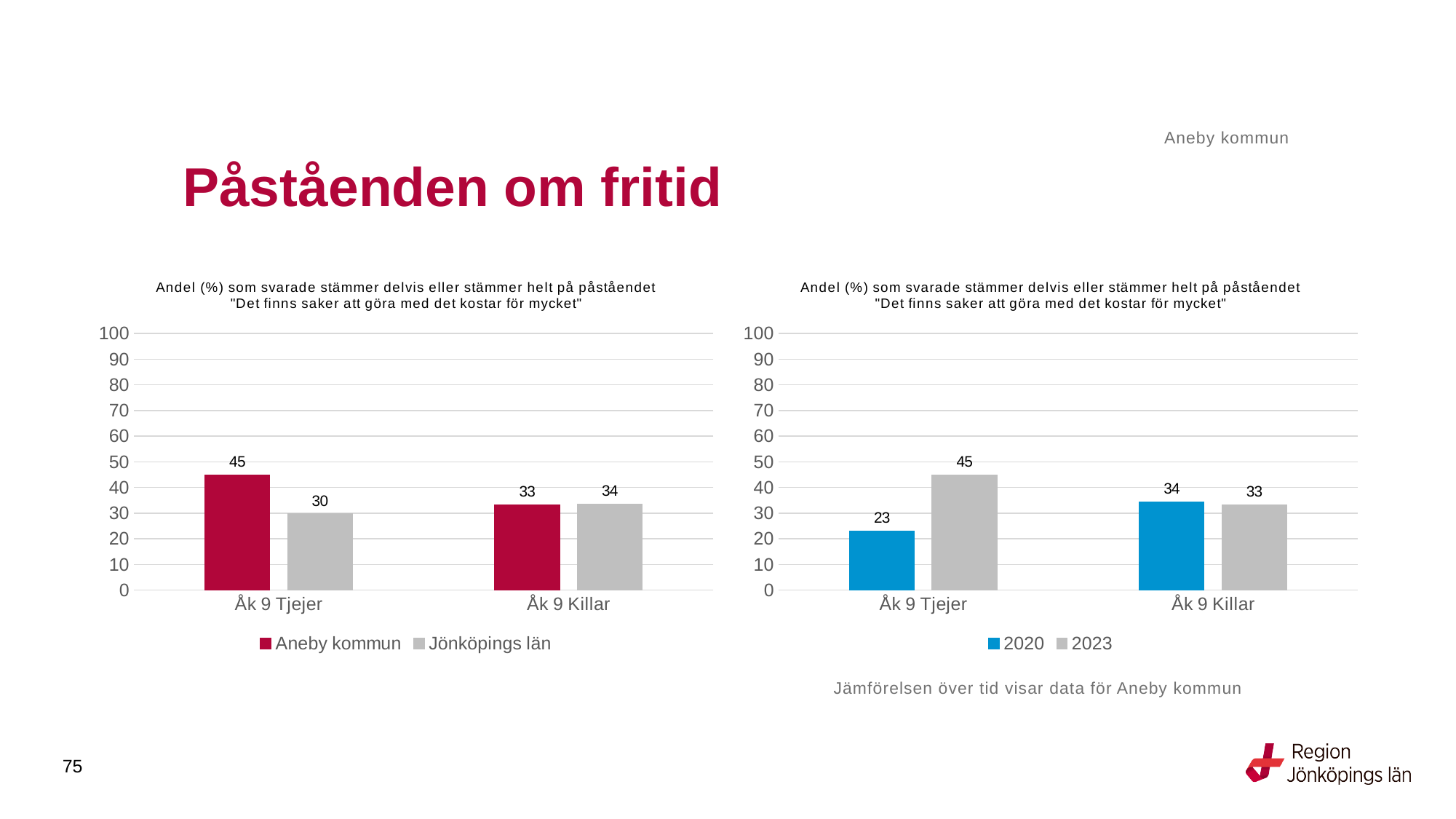
In the left chart, what is the value for Aneby kommun for Åk 9 Tjejer? 45 In the right chart, what is the difference between 2023 and 2020 for Åk 9 Tjejer? 22 In the right chart, which bar has the lowest value? 2020 for Åk 9 Tjejer In the left chart, which category has the highest value for Aneby kommun? Åk 9 Tjejer How many categories are shown on the x axis of the left chart? 2 In the left chart, what is the difference between Aneby kommun and Jönköpings län for Åk 9 Tjejer? 15 In the right chart, which is larger for Åk 9 Tjejer, 2020 or 2023? 2023 What type of chart is the left chart? Bar chart In the right chart, what is the value for 2023 for Åk 9 Killar? 33 In the left chart, what is the value for Jönköpings län for Åk 9 Killar? 34 How many series does the legend of the right chart list? 2 In the right chart, what is the value for 2020 for Åk 9 Tjejer? 23